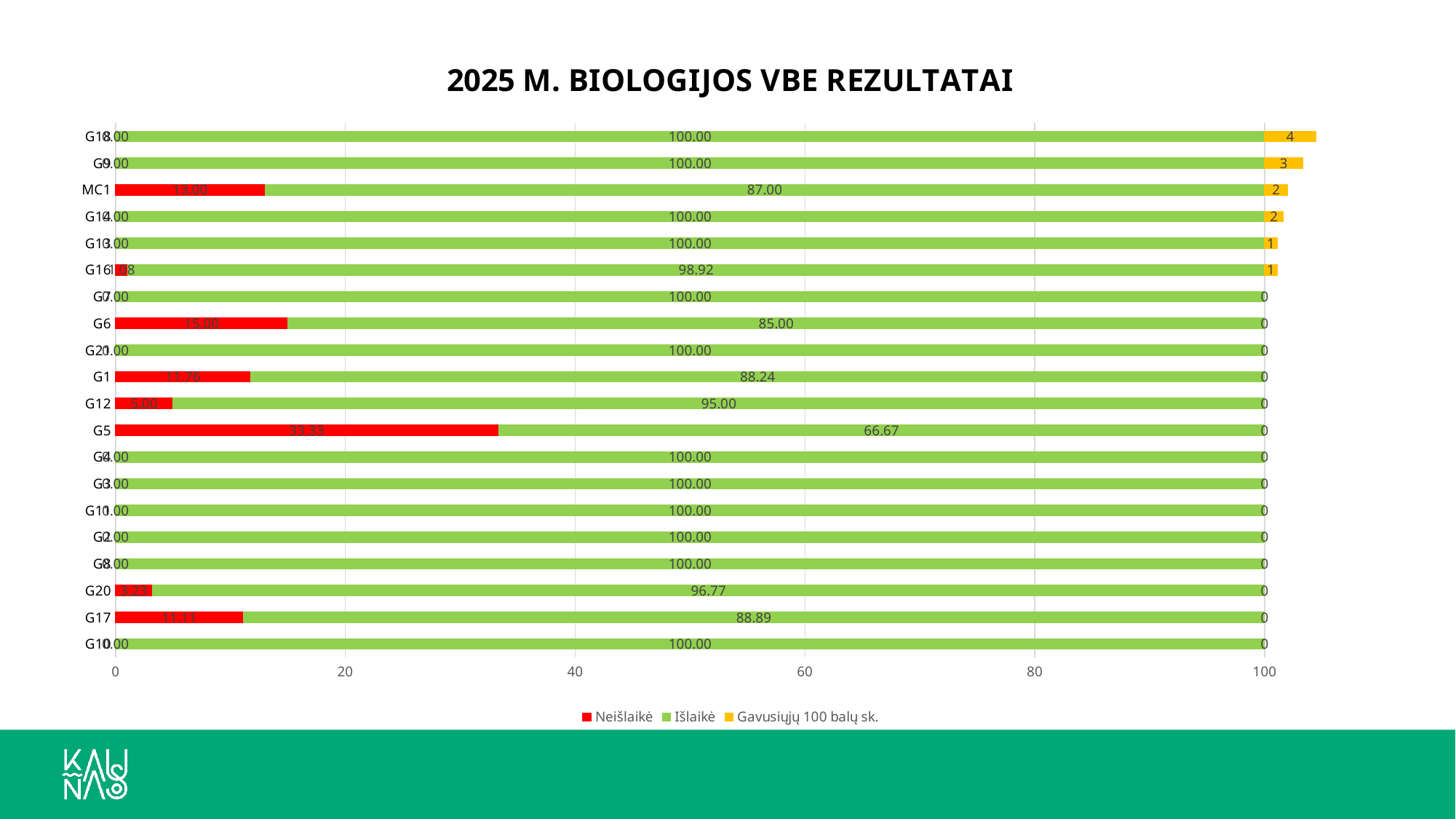
What is the Neišlaikė value for G5? 33.33 Which has a larger Išlaikė value, G1 or G17? G17 What is the difference between the Neišlaikė values for G6 and G12? 10.00 Which category has the lowest Išlaikė value? G5 What kind of chart is shown on the slide? Stacked bar chart What is the title of the chart? 2025 M. BIOLOGIJOS VBE REZULTATAI How many categories are shown on the chart? 20 Which category has the highest Neišlaikė value? G5 What is the Išlaikė value for G20? 96.77 How many series does the legend list? 3 What is the Gavusiųjų 100 balų sk. value for G18? 4 What is the Išlaikė value for MC1? 87.00